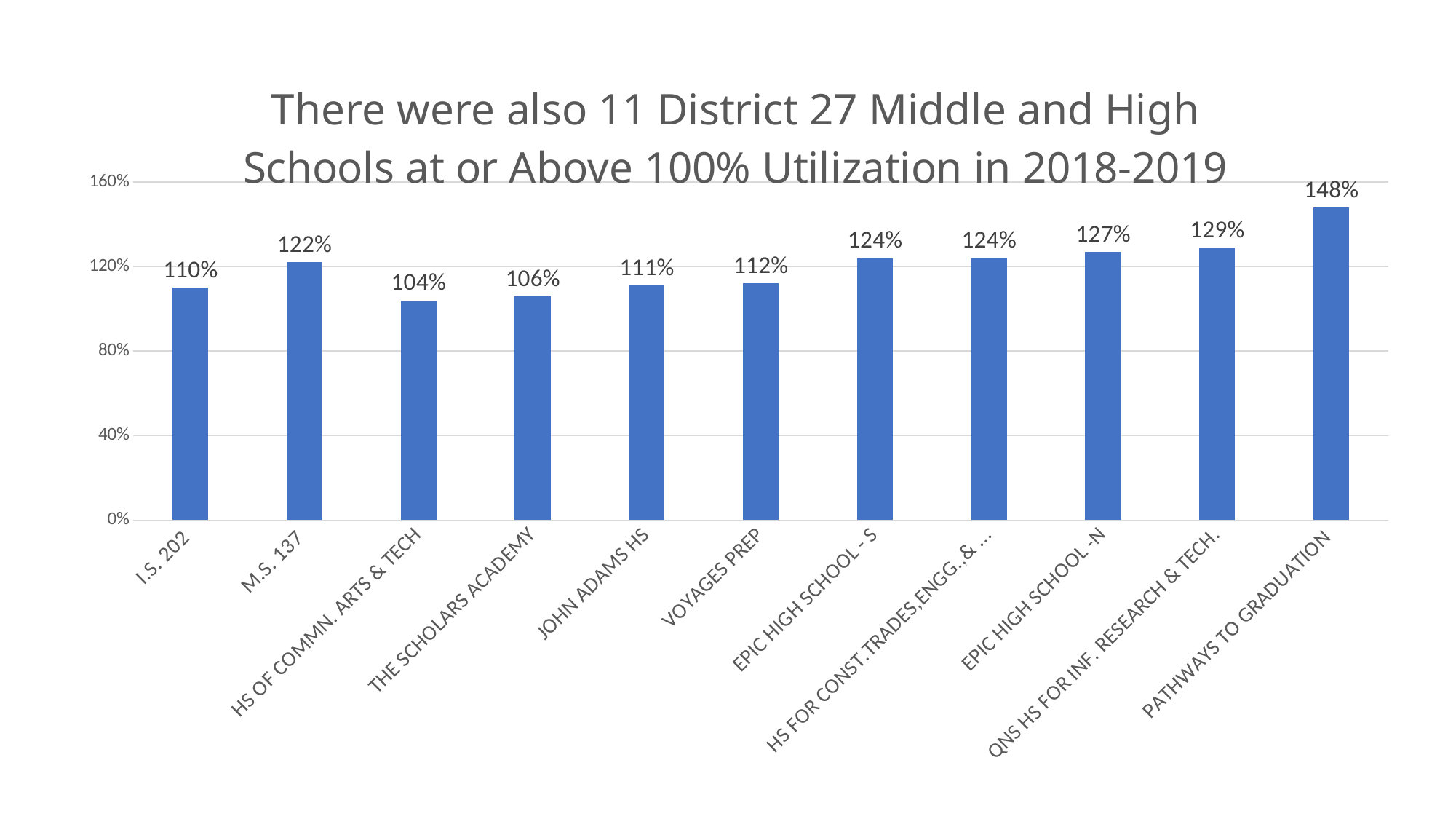
Which school has the highest utilization? PATHWAYS TO GRADUATION What kind of chart is shown on the slide? Bar chart What is the utilization value for QNS HS FOR INF. RESEARCH & TECH.? 129% Is the value for THE SCHOLARS ACADEMY greater or less than 120%? less What is the difference between the utilization of EPIC HIGH SCHOOL - S and I.S. 202? 14% What is the utilization value for JOHN ADAMS HS? 111% What is the utilization value for I.S. 202? 110% What is the difference between the utilization of PATHWAYS TO GRADUATION and M.S. 137? 26% What is the title of the chart? There were also 11 District 27 Middle and High Schools at or Above 100% Utilization in 2018-2019 Which school has the lowest utilization? HS OF COMMN. ARTS & TECH Which has a higher utilization, EPIC HIGH SCHOOL - N or VOYAGES PREP? EPIC HIGH SCHOOL - N How many schools are shown in the chart? 11